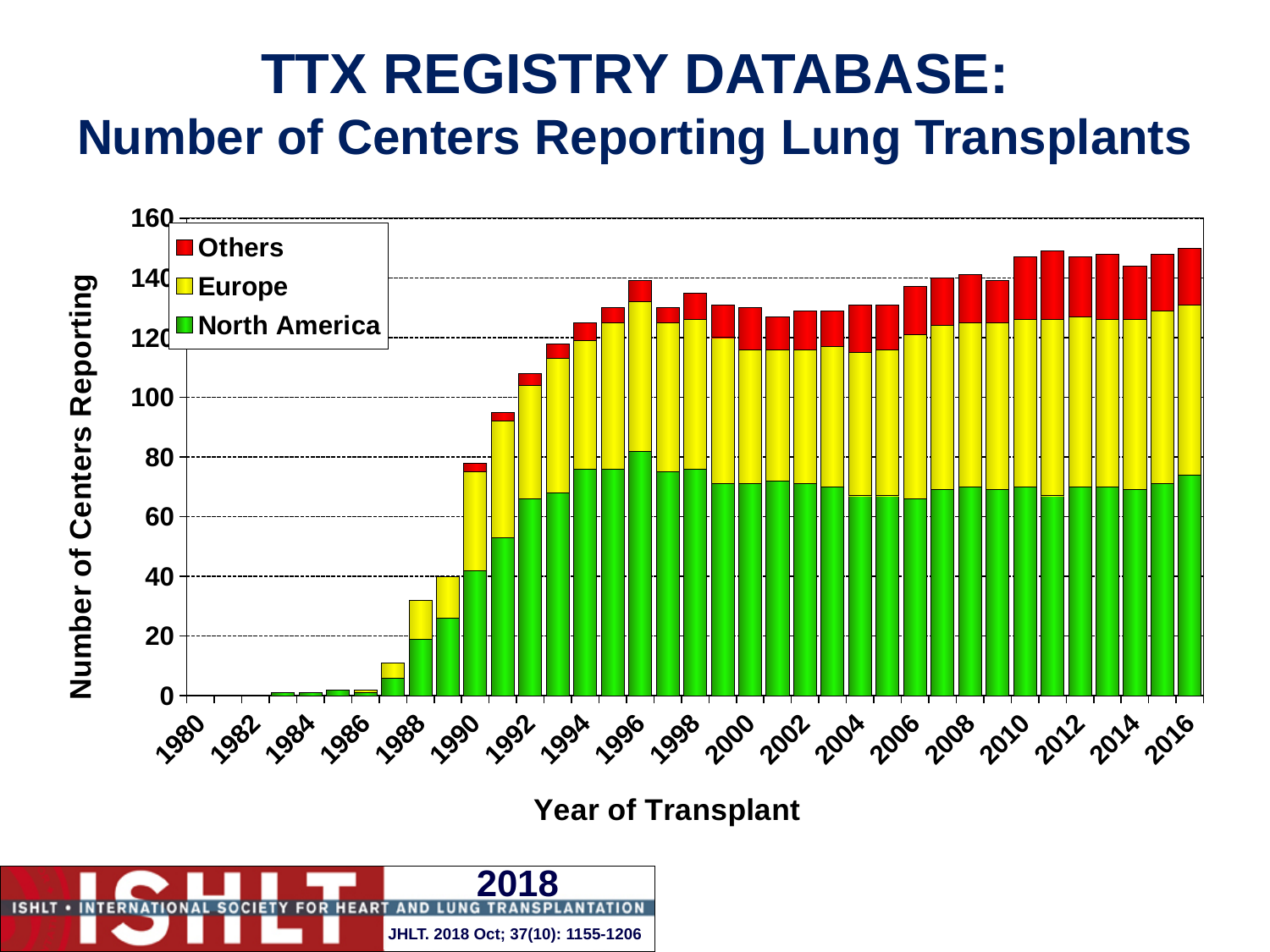
Which year has a higher total number of centers reporting, 1988 or 1990? 1990 Is the total number of centers reporting in 1986 greater or less than 20? less Is the total number of centers reporting in 2016 greater or less than 140? greater What kind of chart is shown on the slide? stacked bar chart Which series is shown in green in the legend? North America Is the total number of centers reporting in 1988 greater or less than 40? less Do the total numbers of centers reporting rise or fall from 1986 to 1996? rise How many series does the legend list? 3 What is the label of the y axis? Number of Centers Reporting